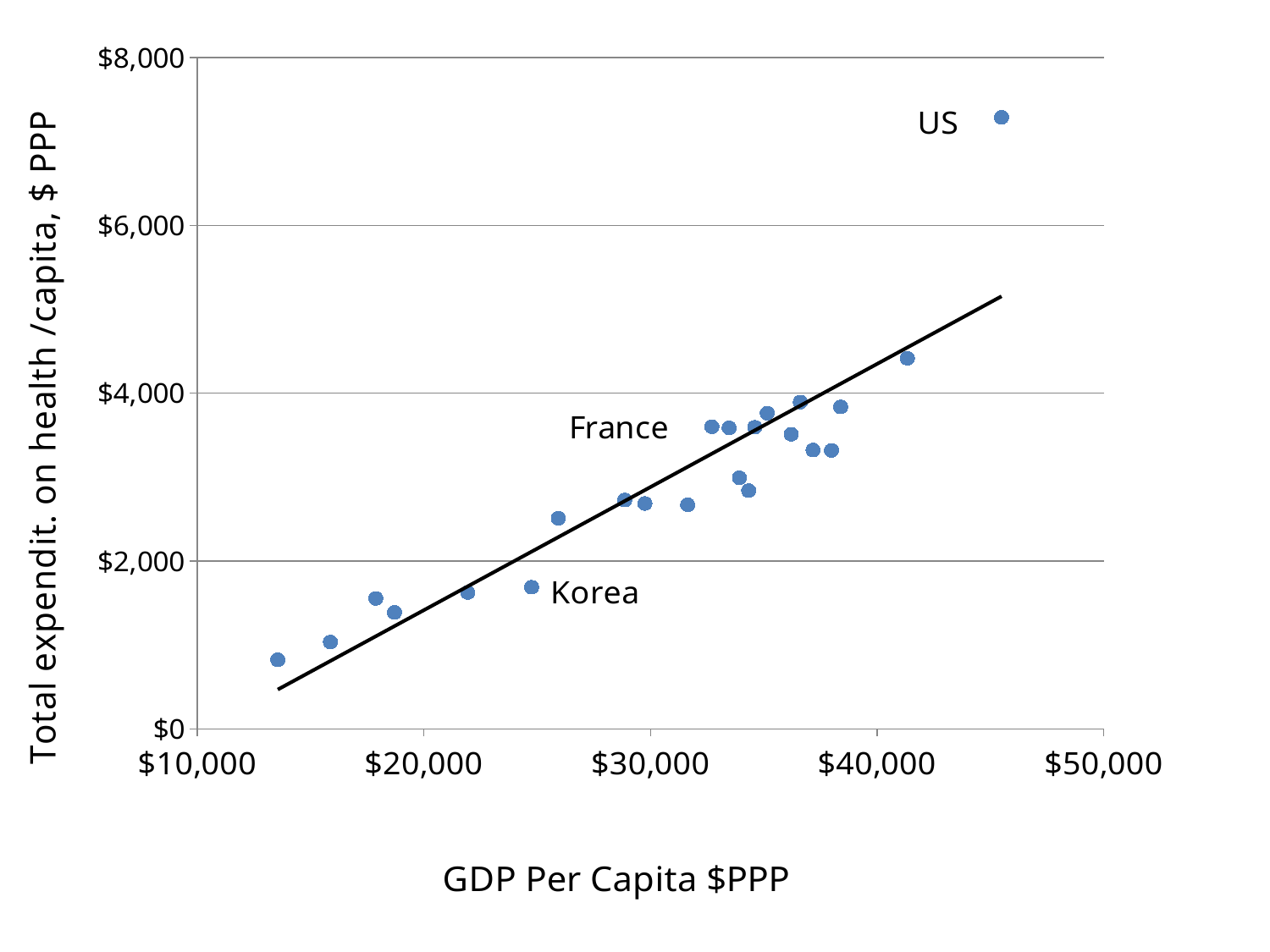
Which has the higher GDP per capita, the US or France? US Is the health expenditure per capita for the US greater or less than $6,000? greater What kind of chart is shown on the slide? scatter plot Is the GDP per capita for Korea greater or less than $30,000? less Which labelled country has the highest total expenditure on health per capita? US Is the GDP per capita for the US greater or less than $40,000? greater What is the label of the x axis? GDP Per Capita $PPP Do the plotted values generally rise or fall as GDP per capita increases? rise Which has the higher health expenditure per capita, France or Korea? France What is the label of the y axis? Total expendit. on health /capita, $ PPP